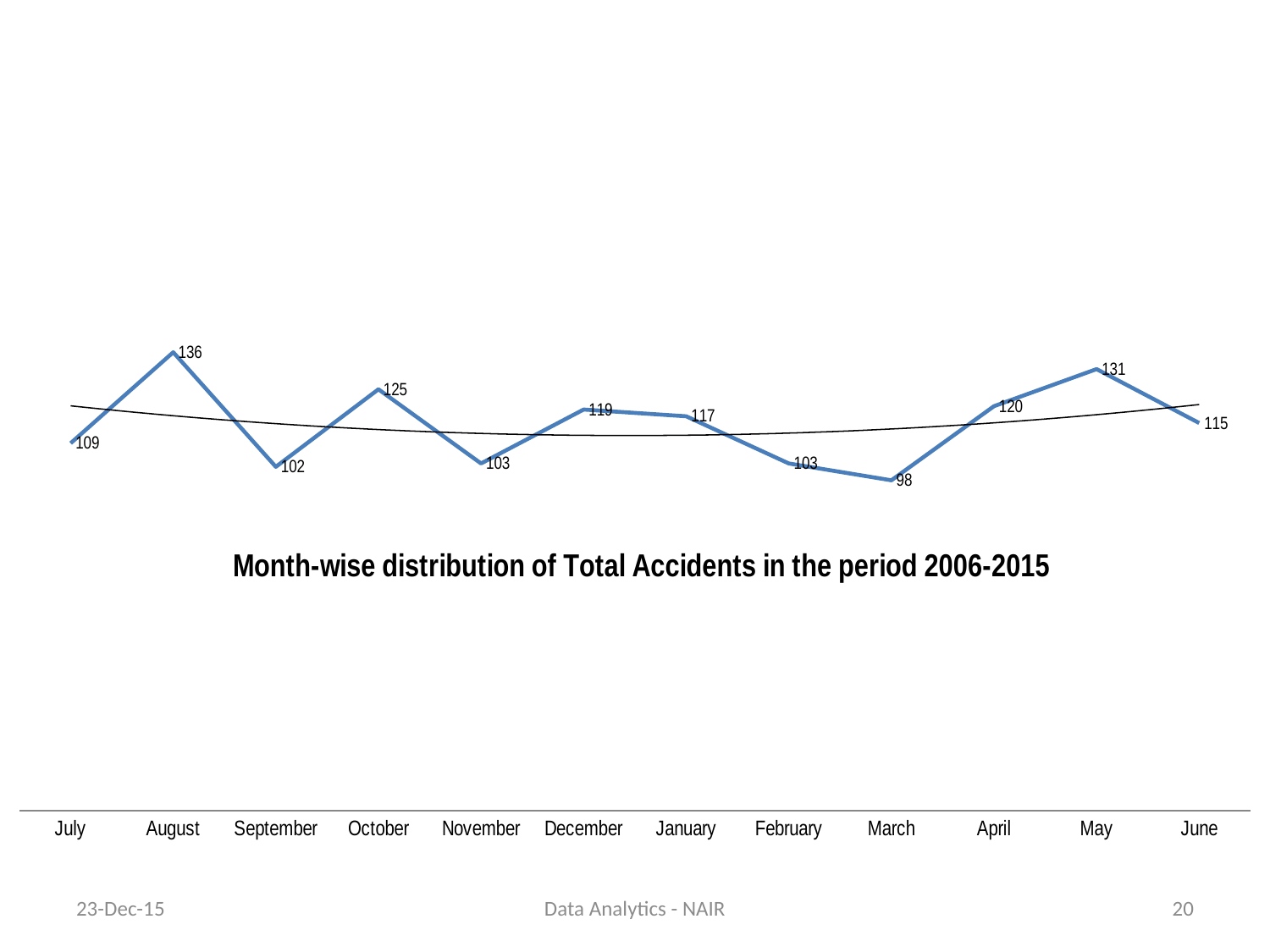
What kind of chart is shown? Line chart What is the difference between the values for August and March? 38 What is the value for August? 136 What is the value for December? 119 What is the value for March? 98 Which month has the lowest value? March Which is larger, the value for October or the value for April? October How many months are plotted on the chart? 12 Which month has the highest value? August Do the values rise or fall from February to May? Rise What is the difference between the values for May and June? 16 What is the title of the chart? Month-wise distribution of Total Accidents in the period 2006-2015